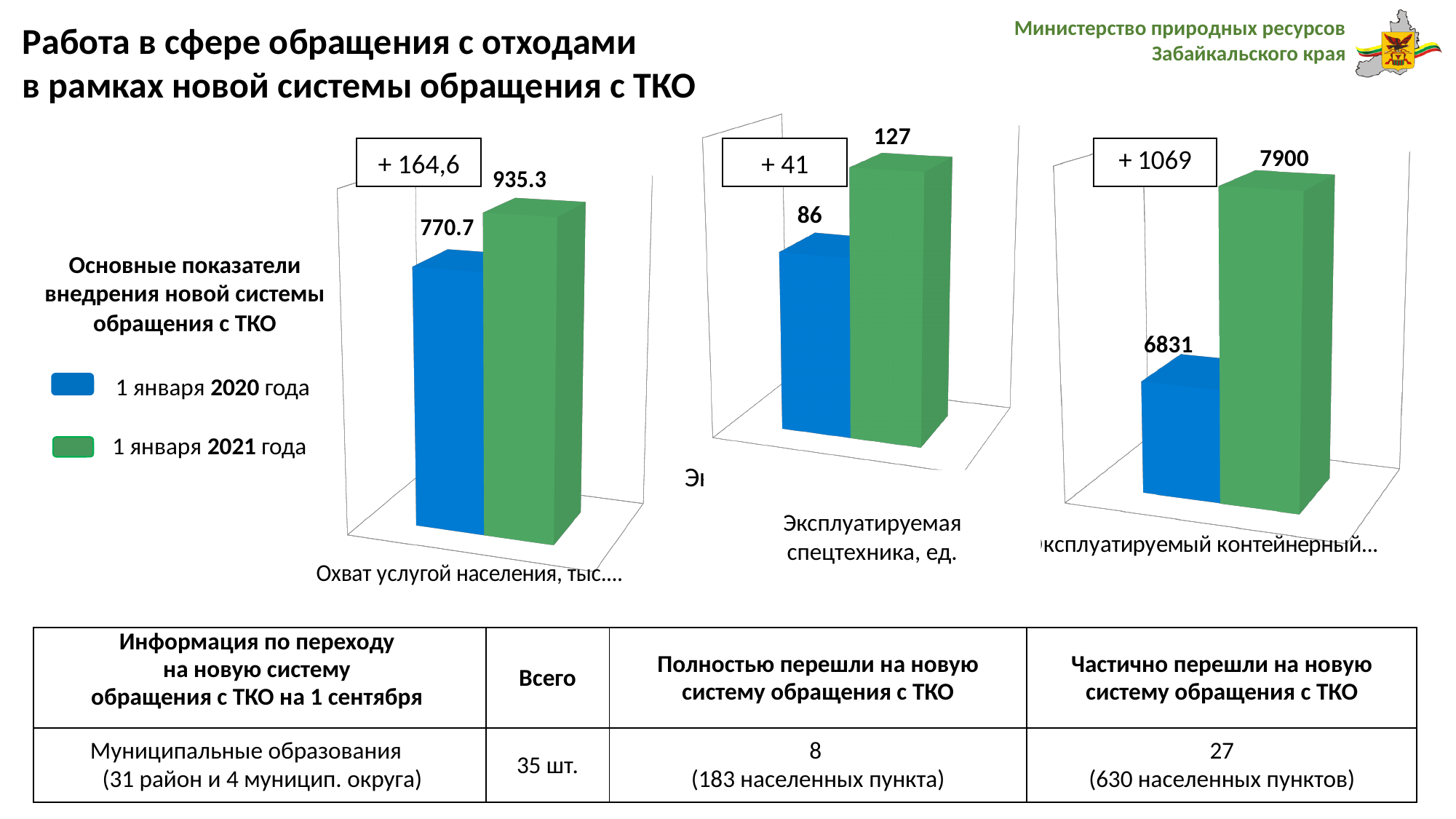
Which colour represents 1 января 2021 года in the legend? Green How many series does the legend list? 2 In the right chart (Эксплуатируемый контейнерный...), what is the value for 1 января 2020 года? 6831 In the middle chart (Эксплуатируемая спецтехника, ед.), what is the value for 1 января 2020 года? 86 In the middle chart (Эксплуатируемая спецтехника, ед.), what is the value for 1 января 2021 года? 127 What kind of chart is used for the three charts on the slide? Bar chart In the right chart (Эксплуатируемый контейнерный...), what is the value for 1 января 2021 года? 7900 In the middle chart (Эксплуатируемая спецтехника, ед.), what is the difference between the 2021 and 2020 values? 41 In the left chart (Охват услугой населения), what is the value for 1 января 2020 года? 770.7 In the right chart (Эксплуатируемый контейнерный...), what is the difference between the 2021 and 2020 values? 1069 In the left chart (Охват услугой населения), which is larger: the value for 1 января 2020 года or for 1 января 2021 года? 1 января 2021 года In the left chart (Охват услугой населения), what is the value for 1 января 2021 года? 935.3